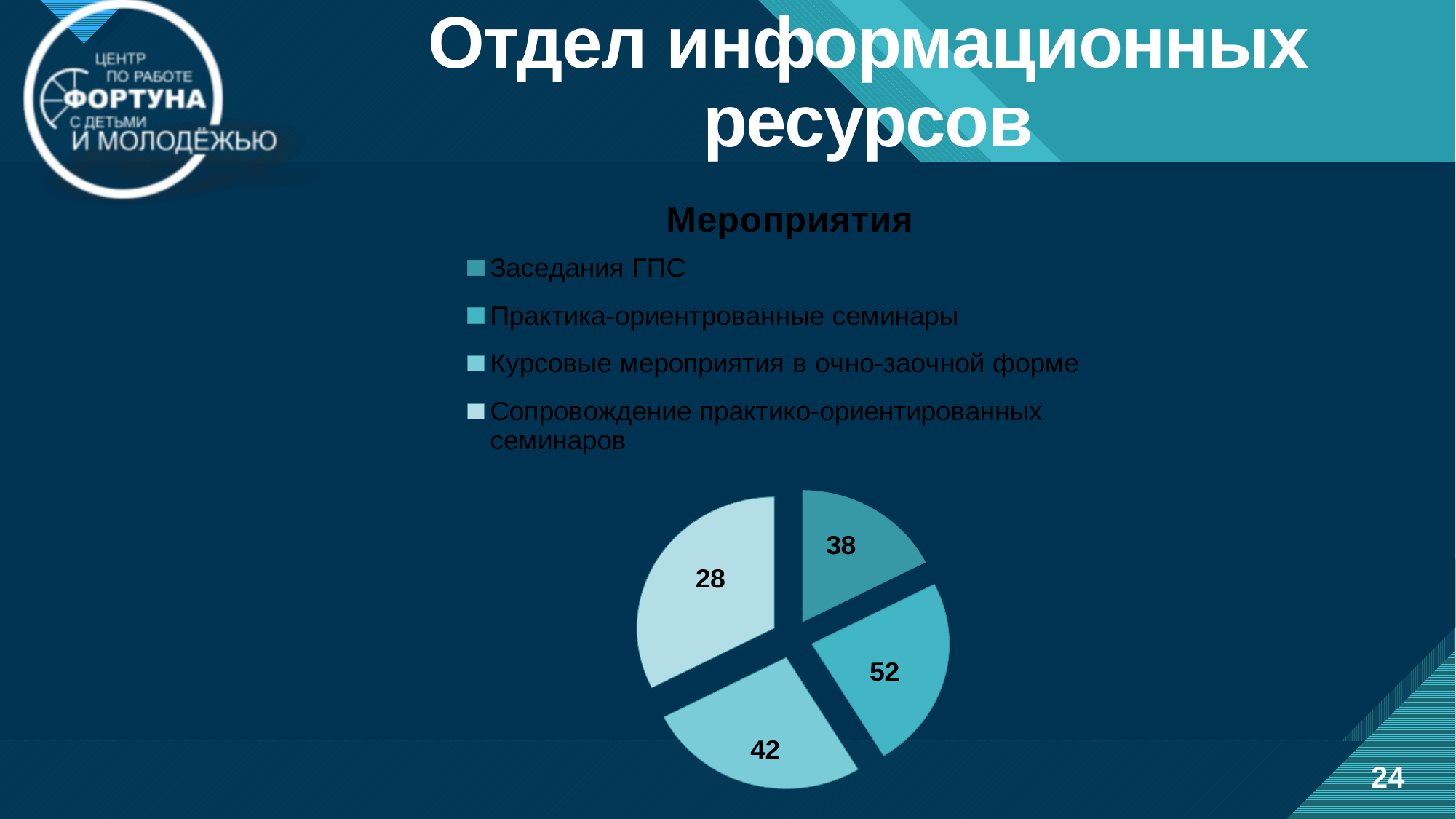
What is the value for Сопровождение практико-ориентированных семинаров? 28 What is the title of the chart? Мероприятия What is the value for Заседания ГПС? 38 Which category has the smallest slice? Заседания ГПС How many slices does the pie chart have? 4 What is the value for Практика-ориентрованные семинары? 52 What is the difference between the values for Практика-ориентрованные семинары and Заседания ГПС? 14 What kind of chart is shown on the slide? pie chart How many entries does the chart legend list? 4 Which category has the largest slice? Сопровождение практико-ориентированных семинаров What is the value for Курсовые мероприятия в очно-заочной форме? 42